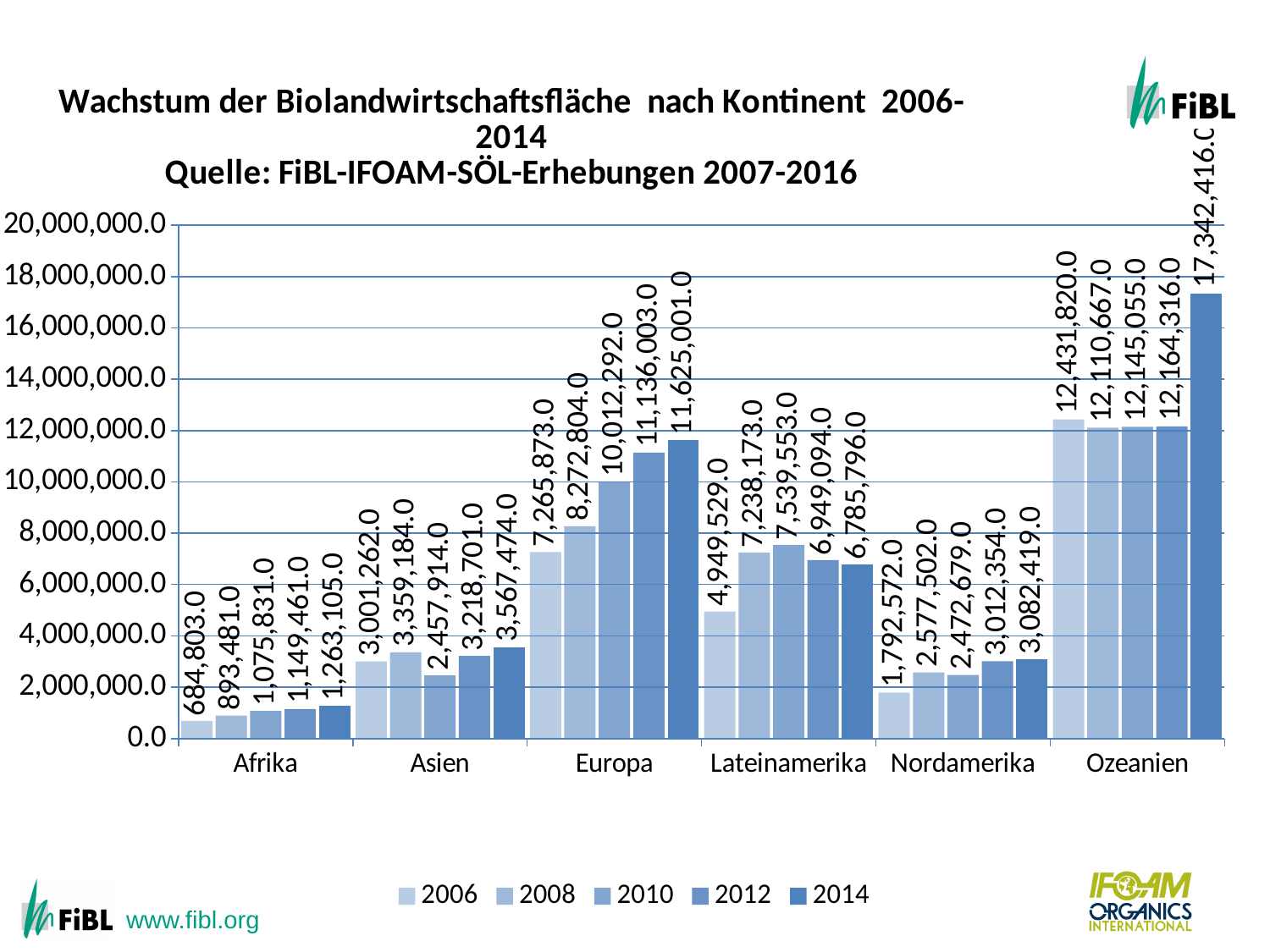
Which continent has the highest value in 2014? Ozeanien Do the values for Afrika rise or fall from 2006 to 2014? rise What is the value for Nordamerika in 2012? 3,012,354.0 What is the value for Lateinamerika in 2010? 7,539,553.0 What type of chart is shown on the slide? bar chart What is the value for Europa in 2014? 11,625,001.0 Which is larger, the 2014 value for Asien or the 2014 value for Nordamerika? Asien What is the value for Afrika in 2006? 684,803.0 Which continent has the lowest value in 2006? Afrika What is the difference between the 2014 and 2006 values for Europa? 4,359,128.0 How many series does the legend list? 5 How many continents are shown on the x axis? 6